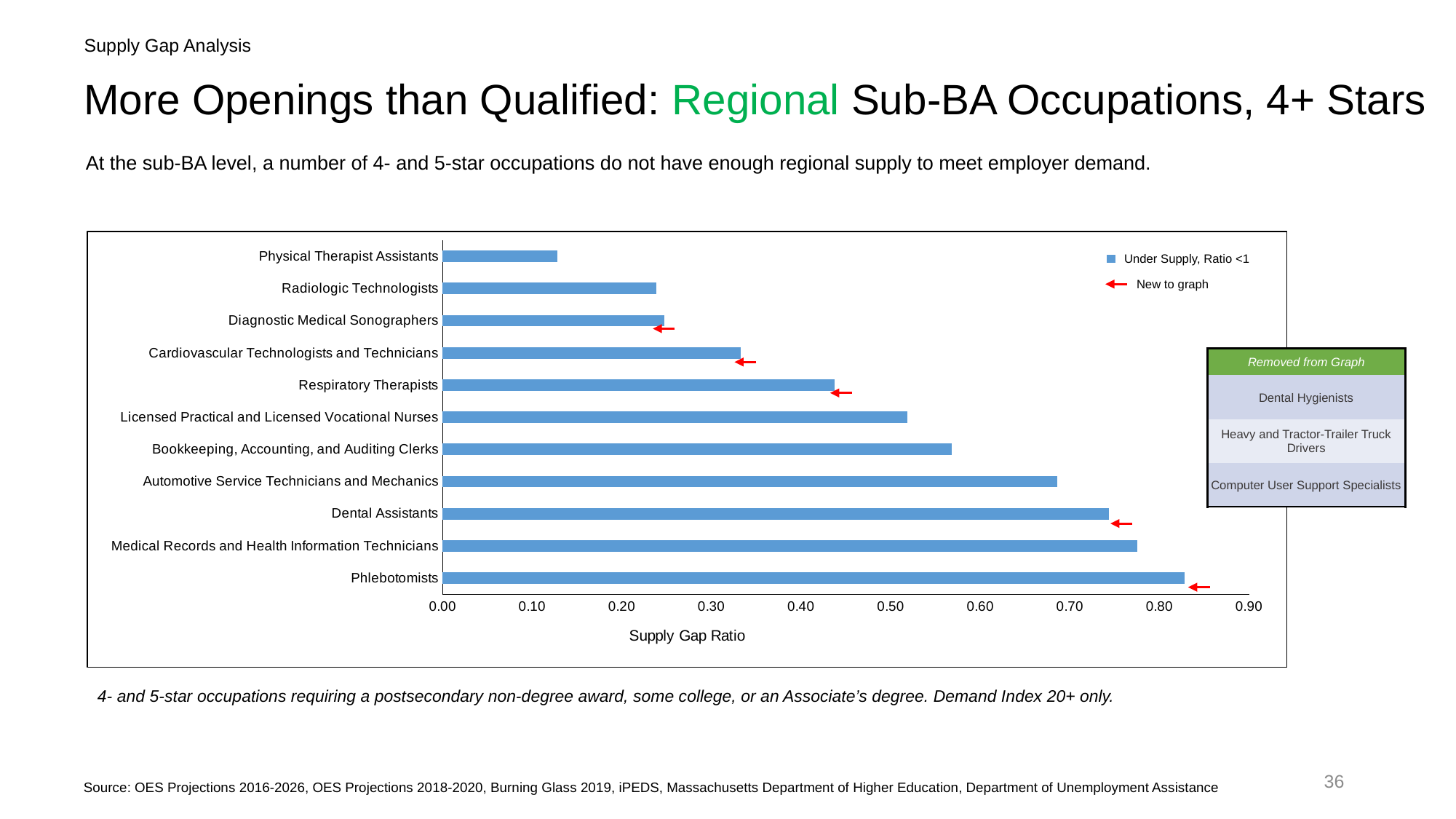
What is the title of the horizontal axis? Supply Gap Ratio Is the supply gap ratio for Physical Therapist Assistants greater or less than 0.20? less What kind of chart is shown on the slide? Bar chart Is the supply gap ratio for Respiratory Therapists greater or less than 0.40? greater Is the supply gap ratio for Radiologic Technologists greater or less than 0.30? less Which occupation has the lowest supply gap ratio? Physical Therapist Assistants Do the bars get longer or shorter moving from the top of the chart to the bottom? Longer Which has a larger supply gap ratio, Dental Assistants or Respiratory Therapists? Dental Assistants How many occupations are plotted in the chart? 11 Which occupation has the highest supply gap ratio? Phlebotomists